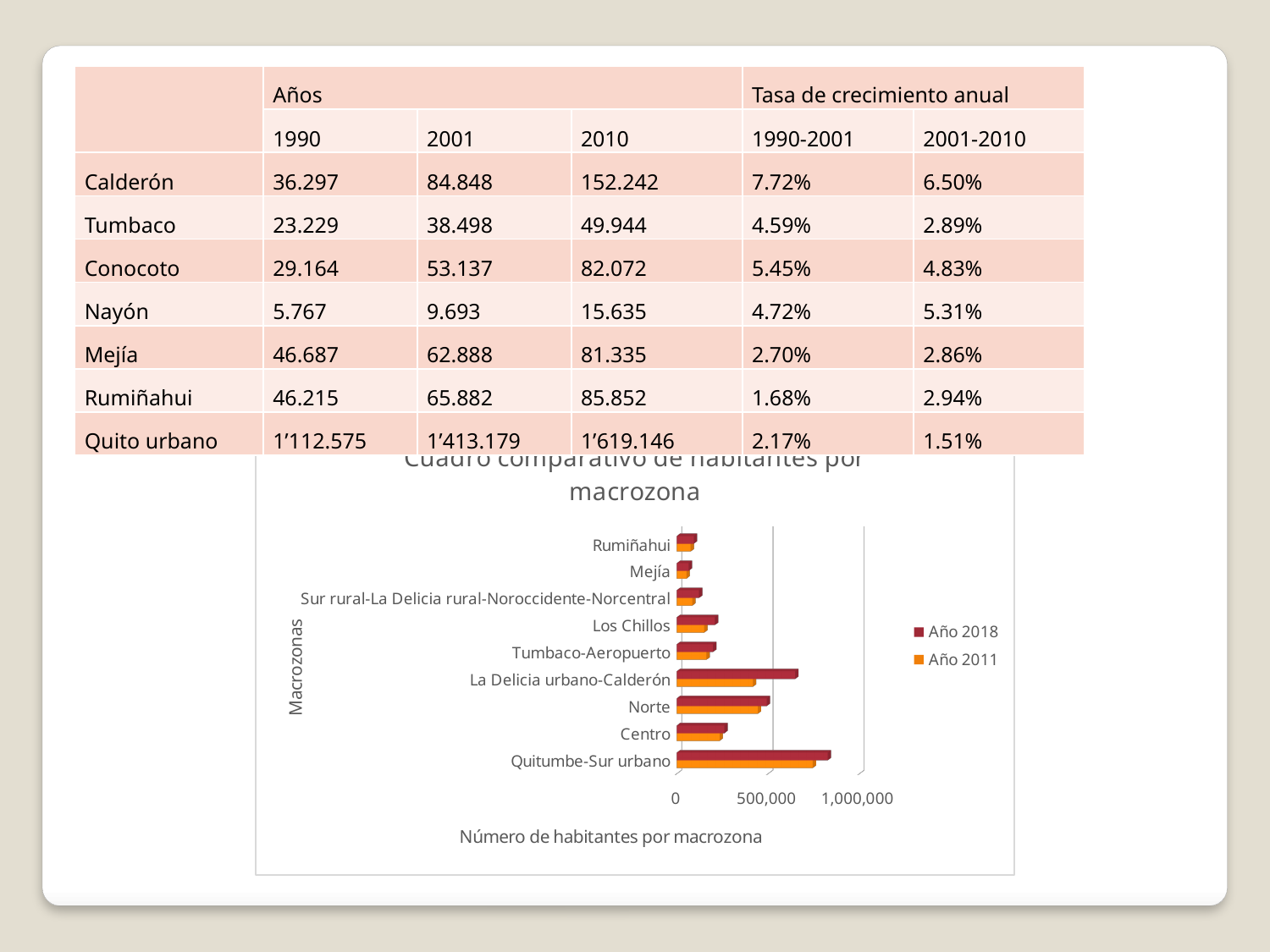
How many series does the legend of the chart list? 2 How many macrozonas (categories) are plotted in the chart? 9 What are the two series named in the chart legend? Año 2018 and Año 2011 Which macrozona has the highest number of inhabitants in the chart for Año 2018? Quitumbe-Sur urbano Is the Año 2018 value for Quitumbe-Sur urbano greater or less than 500,000? greater What is the title of the chart's horizontal axis? Número de habitantes por macrozona Which has more inhabitants in Año 2018: La Delicia urbano-Calderón or Los Chillos? La Delicia urbano-Calderón Is the Año 2018 value for La Delicia urbano-Calderón greater or less than 500,000? greater Which has more inhabitants in Año 2018: Quitumbe-Sur urbano or Centro? Quitumbe-Sur urbano Is the Año 2011 value for Mejía greater or less than 500,000? less Which macrozona has the lowest number of inhabitants in the chart for Año 2018? Mejía What kind of chart is shown on the slide? Bar chart